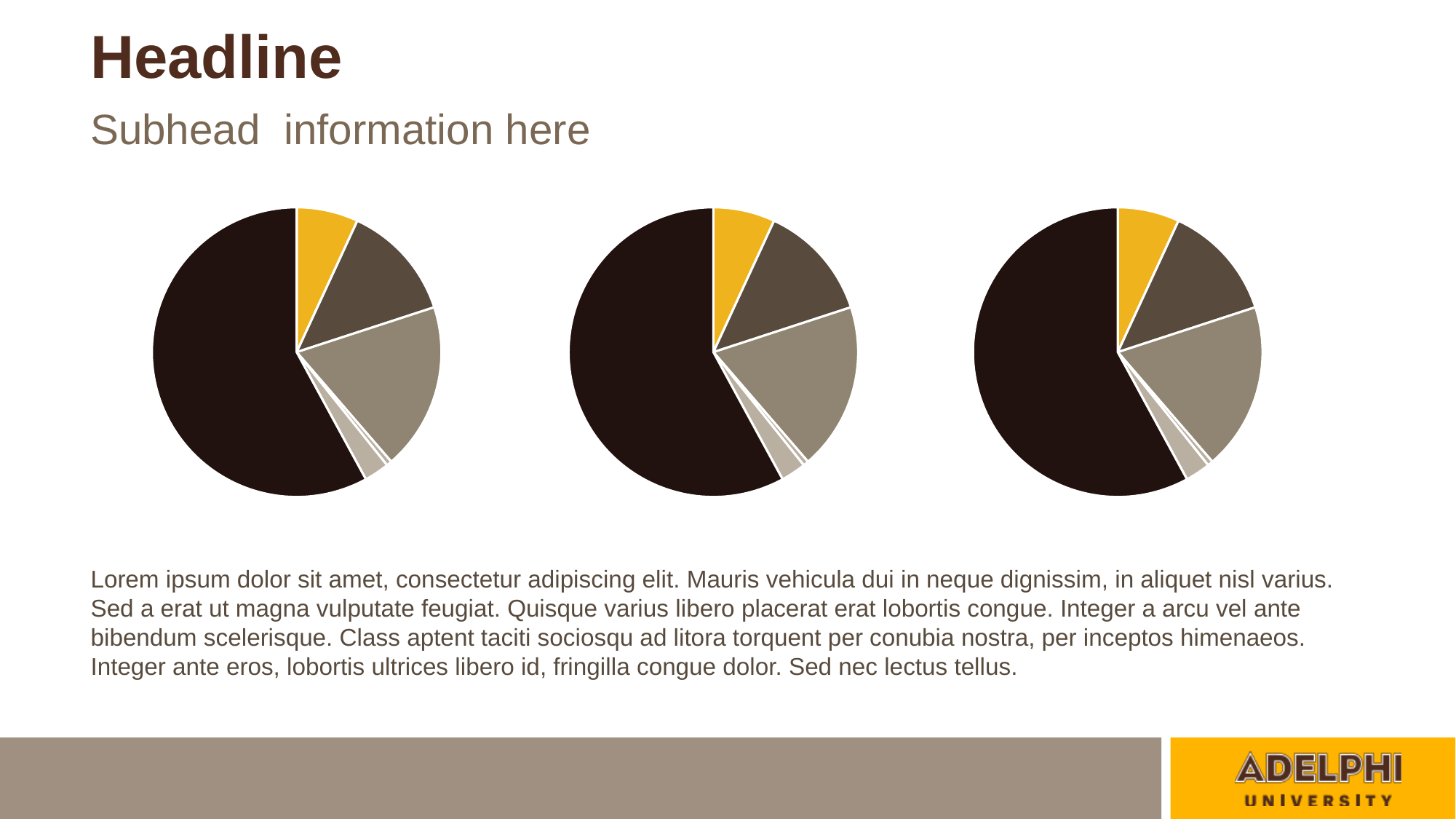
Do the pie charts on the slide show a legend? No In the left pie chart, which is larger, the dark brown slice or the tan slice? The dark brown slice What kind of chart is shown on the left of the slide? Pie chart In the left pie chart, which colour slice is the largest? Dark brown Do the pie charts on the slide display data labels with values? No In the middle pie chart, which colour slice is the largest? Dark brown How many pie charts are on the slide? 3 In the middle pie chart, which is larger, the yellow slice or the tan (grey-beige) slice? The tan slice In the right pie chart, does the dark brown slice take up more or less than half of the pie? More than half In the right pie chart, which is larger, the yellow slice or the dark grey-brown slice next to it? The dark grey-brown slice